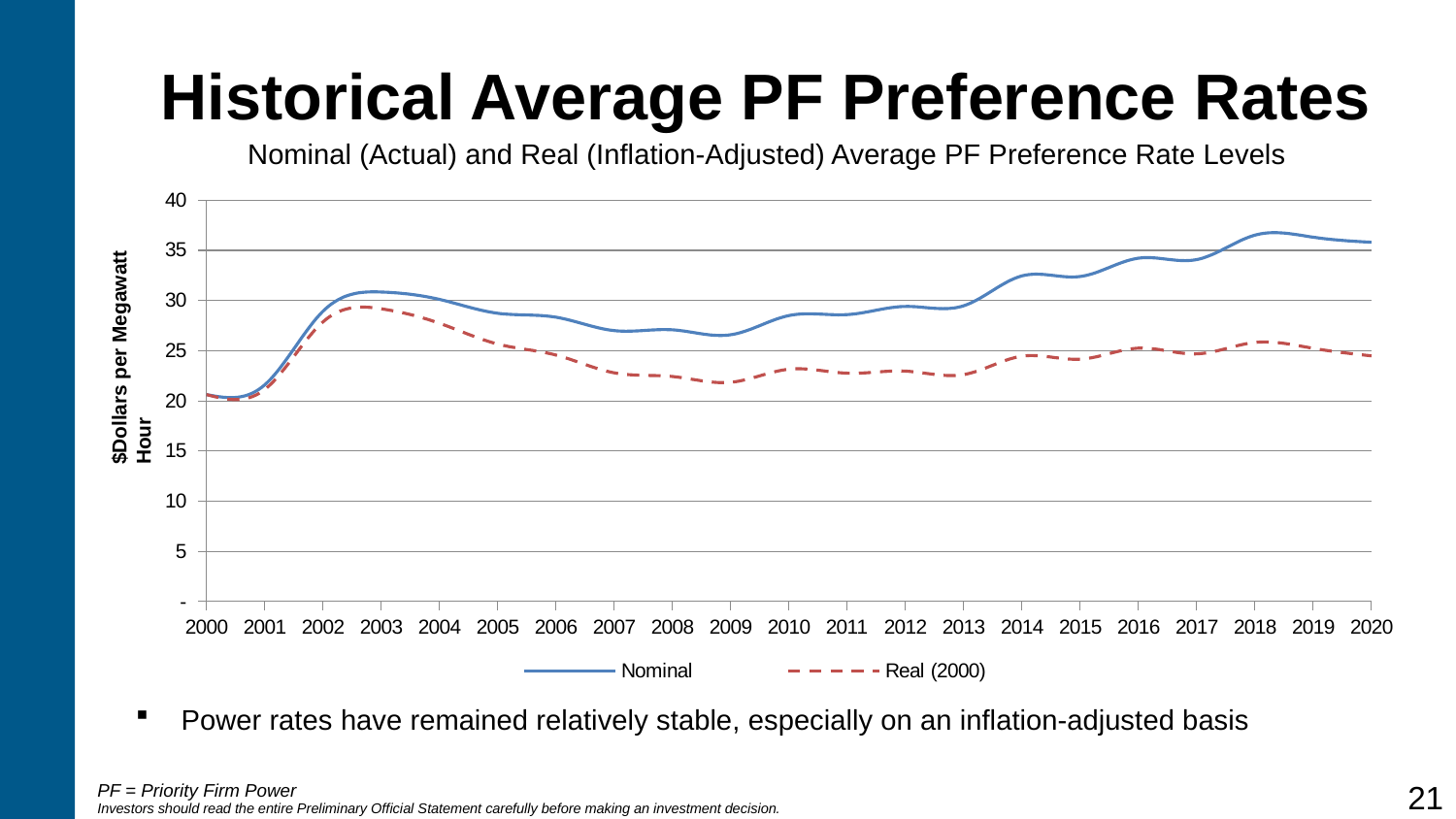
Is the Real (2000) value for 2009 greater or less than 25? less Is the Nominal value for 2014 greater or less than 30? greater Does the Nominal series rise or fall between 2013 and 2018? Rise In 2020, which series has the higher value, Nominal or Real (2000)? Nominal What is the label on the y axis of the chart? $Dollars per Megawatt Hour Does the Real (2000) series rise or fall between 2003 and 2009? Fall What kind of chart is shown on the slide? Line chart How many series does the legend list? 2 How many years are shown along the x axis? 21 Is the Real (2000) value for 2007 greater or less than 25? less In which year does the Real (2000) series reach its highest value? 2003